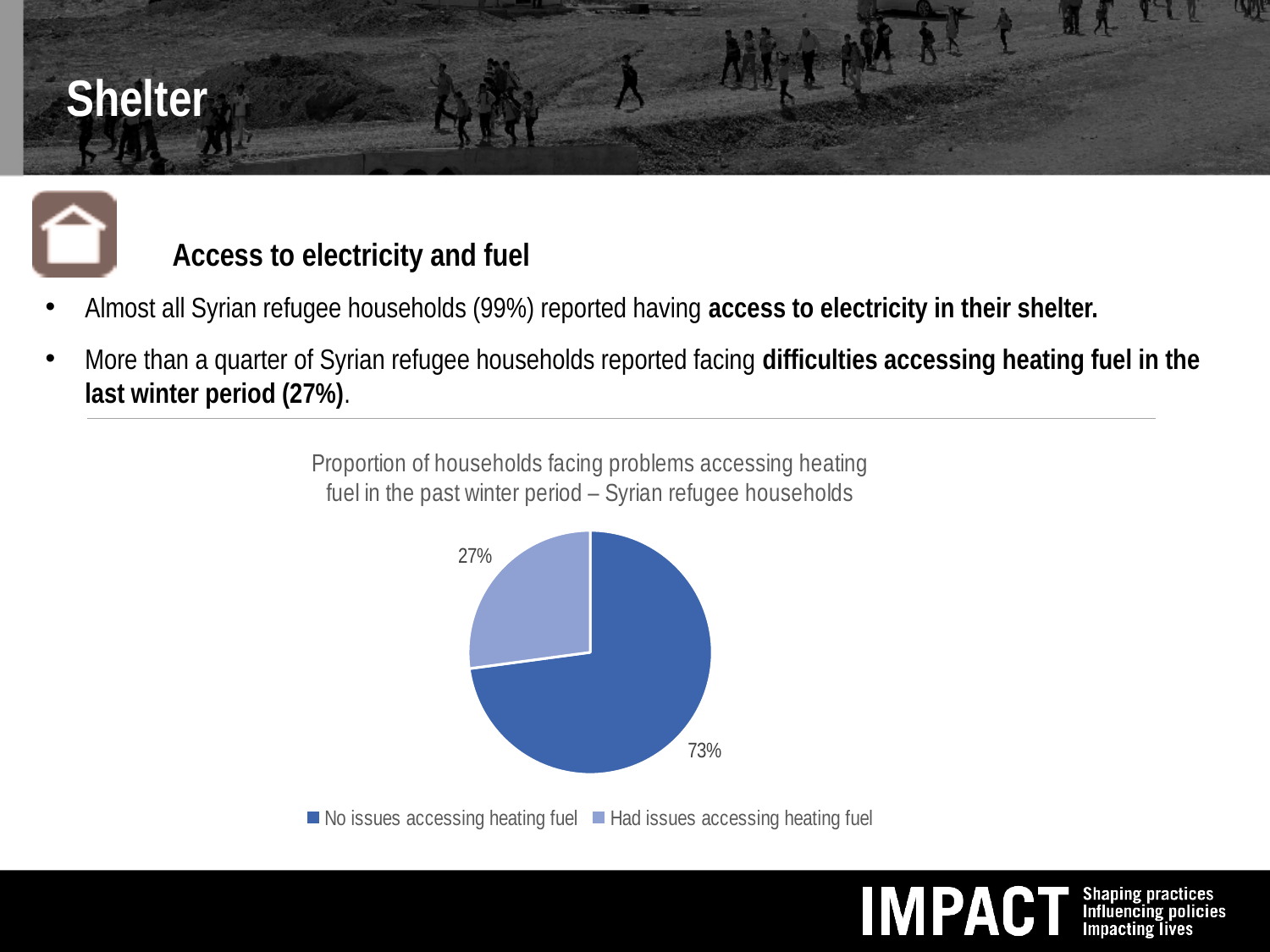
What is the title of the chart? Proportion of households facing problems accessing heating fuel in the past winter period – Syrian refugee households What percentage of households had issues accessing heating fuel? 27% What share of the pie is taken by the 'Had issues accessing heating fuel' slice? 27% What percentage of households had no issues accessing heating fuel? 73% What kind of chart is shown on the slide? Pie chart How many slices does the pie chart have? 2 Which category has the smallest share of the pie? Had issues accessing heating fuel How many entries does the legend list? 2 What is the difference in percentage points between households with no issues and households that had issues accessing heating fuel? 46 Which is larger: the share of households with no issues accessing heating fuel or the share that had issues? No issues accessing heating fuel Which category has the largest share of the pie? No issues accessing heating fuel Which legend entry is shown in the lighter blue colour? Had issues accessing heating fuel